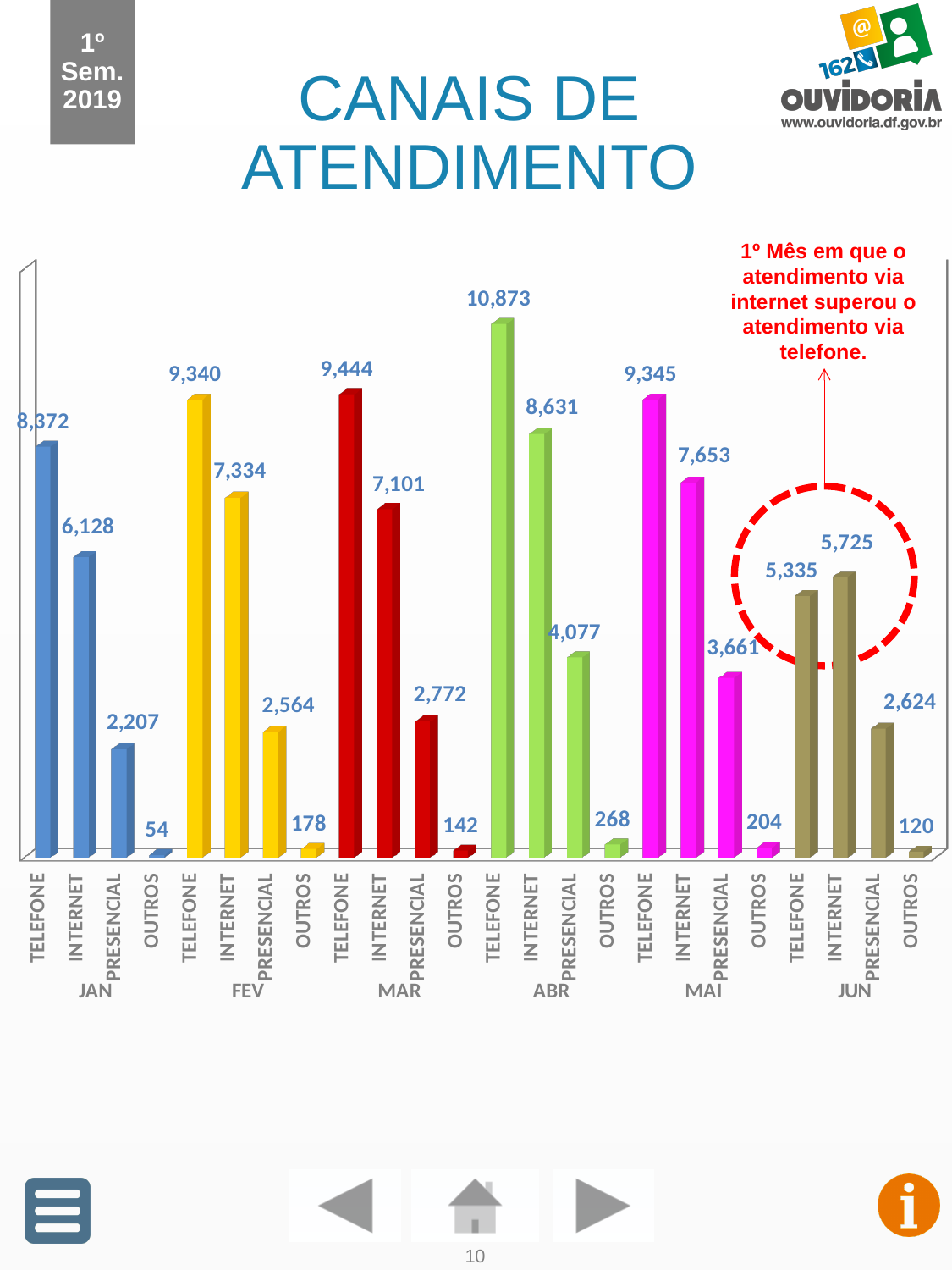
What is the value for OUTROS in JAN? 54 How many months are shown on the x axis? 6 Which is larger in JUN, TELEFONE or INTERNET? INTERNET What is the value for PRESENCIAL in MAI? 3,661 What is the value for TELEFONE in ABR? 10,873 Which bar has the highest value on the chart? TELEFONE in ABR Which bar has the lowest value on the chart? OUTROS in JAN What is the value for INTERNET in JUN? 5,725 What is the difference between INTERNET and TELEFONE in JUN? 390 What is the difference between TELEFONE and INTERNET in JAN? 2,244 What type of chart is shown on the slide? Bar chart How many bars are plotted on the chart in total? 24